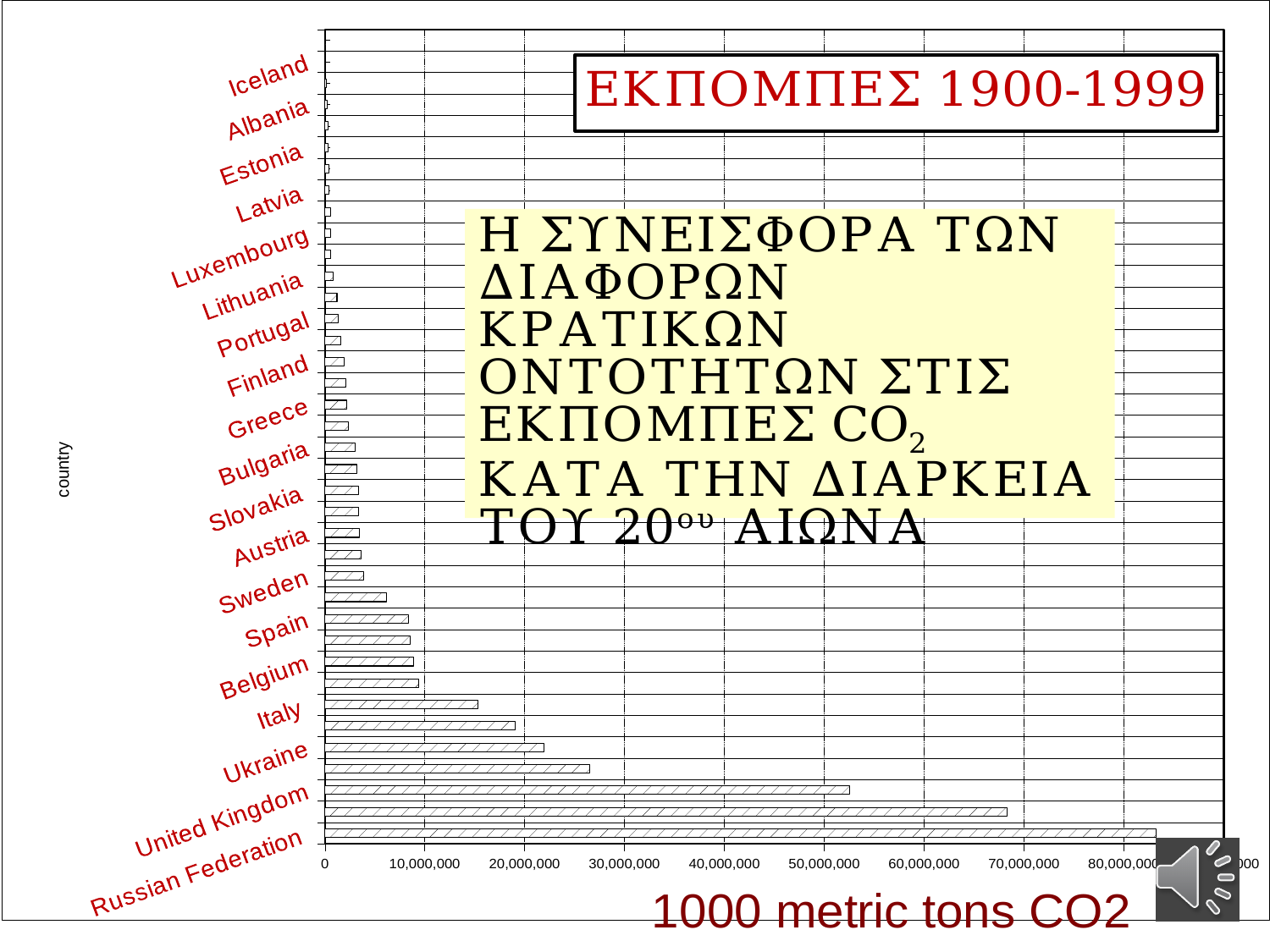
What is the title of the chart? ΕΚΠΟΜΠΕΣ 1900-1999 Is the value for Russian Federation greater or less than 80,000,000? greater Which country has the highest emissions value in the chart? Russian Federation What kind of chart is shown on the slide? bar chart Is the value for Iceland greater or less than 10,000,000? less Do the bar values increase or decrease going from the top of the chart to the bottom? increase Which has the larger value, Russian Federation or Iceland? Russian Federation How many country labels are printed on the vertical axis? 19 Which country label appears at the top of the vertical axis? Iceland What is the label of the horizontal axis? 1000 metric tons CO2